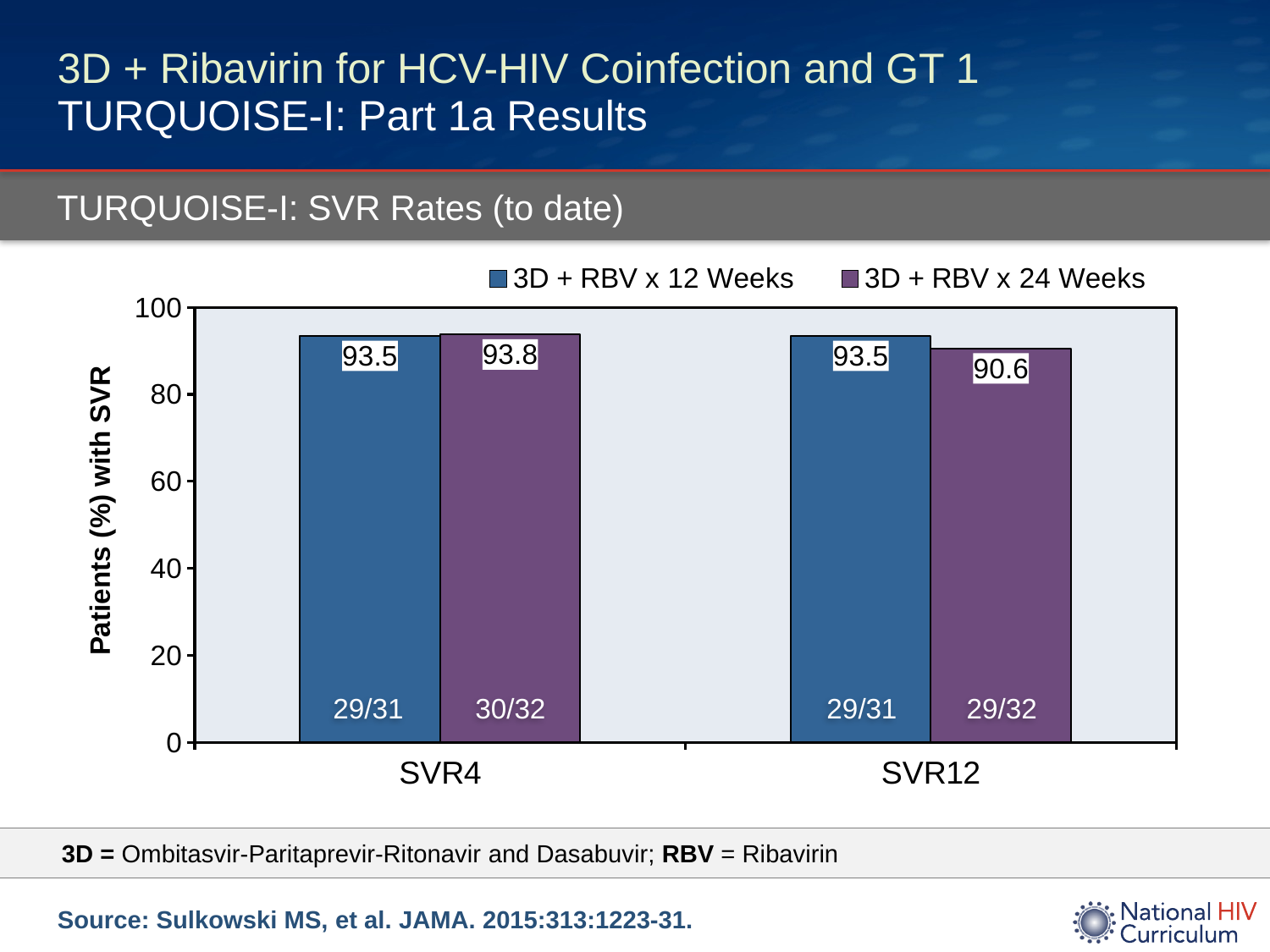
What is the difference between the SVR4 and SVR12 rates for 3D + RBV x 24 Weeks? 3.2 How many series does the legend list? 2 Which series has the lowest SVR12 rate? 3D + RBV x 24 Weeks Is the SVR12 value for 3D + RBV x 24 Weeks greater or less than 80? greater What kind of chart is shown on the slide? Bar chart What is the SVR4 rate for 3D + RBV x 12 Weeks? 93.5 What is the SVR12 rate for 3D + RBV x 24 Weeks? 90.6 At SVR12, which series has the higher rate, 3D + RBV x 12 Weeks or 3D + RBV x 24 Weeks? 3D + RBV x 12 Weeks What is the SVR4 rate for 3D + RBV x 24 Weeks? 93.8 How many categories are shown on the x axis? 2 What is the label of the y axis? Patients (%) with SVR What fraction of patients is shown inside the SVR12 bar for 3D + RBV x 24 Weeks? 29/32